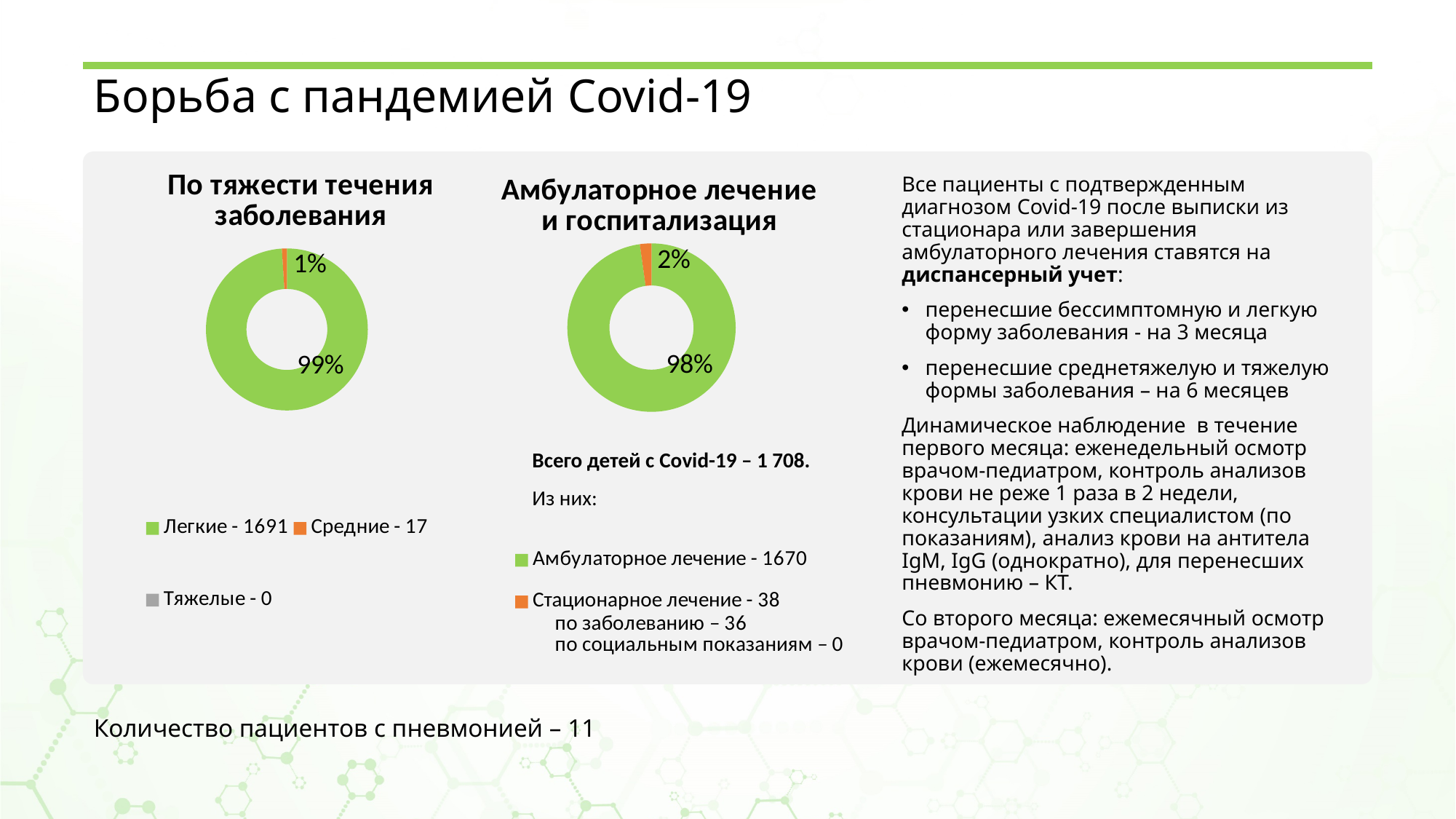
In the chart titled «Амбулаторное лечение и госпитализация», what value does the legend give for «Амбулаторное лечение»? 1670 In the chart titled «По тяжести течения заболевания», how many categories does the legend list? 3 What type of chart is used for «Амбулаторное лечение и госпитализация»? Doughnut (pie) chart In the chart titled «Амбулаторное лечение и госпитализация», what value does the legend give for «Стационарное лечение»? 38 In the chart titled «По тяжести течения заболевания», what value does the legend give for «Тяжелые»? 0 In the chart titled «По тяжести течения заболевания», which category has the largest value? Легкие In the chart titled «Амбулаторное лечение и госпитализация», which is larger: «Амбулаторное лечение» or «Стационарное лечение»? Амбулаторное лечение In the chart titled «По тяжести течения заболевания», what value does the legend give for «Легкие»? 1691 In the chart titled «По тяжести течения заболевания», what is the difference between the values for «Легкие» and «Средние»? 1674 In the chart titled «Амбулаторное лечение и госпитализация», what percentage share is shown for «Стационарное лечение»? 2% In the chart titled «По тяжести течения заболевания», what percentage share is shown for the «Легкие» slice? 99% In the chart titled «По тяжести течения заболевания», what percentage share is shown for the «Средние» slice? 1%